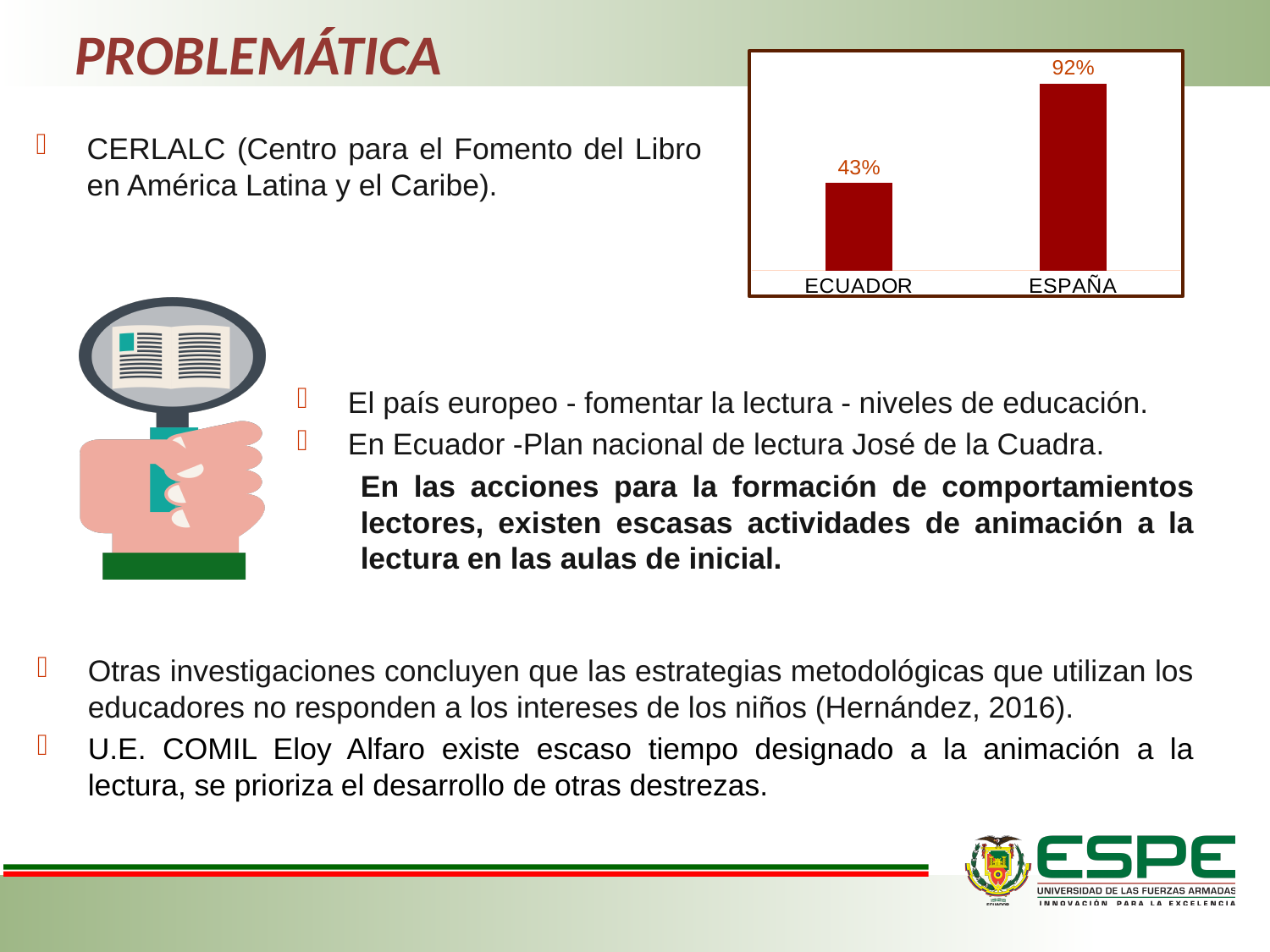
What is the value shown for ECUADOR in the chart? 43% How many categories are shown in the chart? 2 What kind of chart is shown on the slide? Bar chart Which is larger, the value for ECUADOR or the value for ESPAÑA? ESPAÑA Which category has the lowest value in the chart? ECUADOR What is the difference between the values for ESPAÑA and ECUADOR? 49% Do the values rise or fall from ECUADOR to ESPAÑA? Rise What is the value shown for ESPAÑA in the chart? 92% Which category has the highest value in the chart? ESPAÑA What colour are the bars in the chart? Dark red